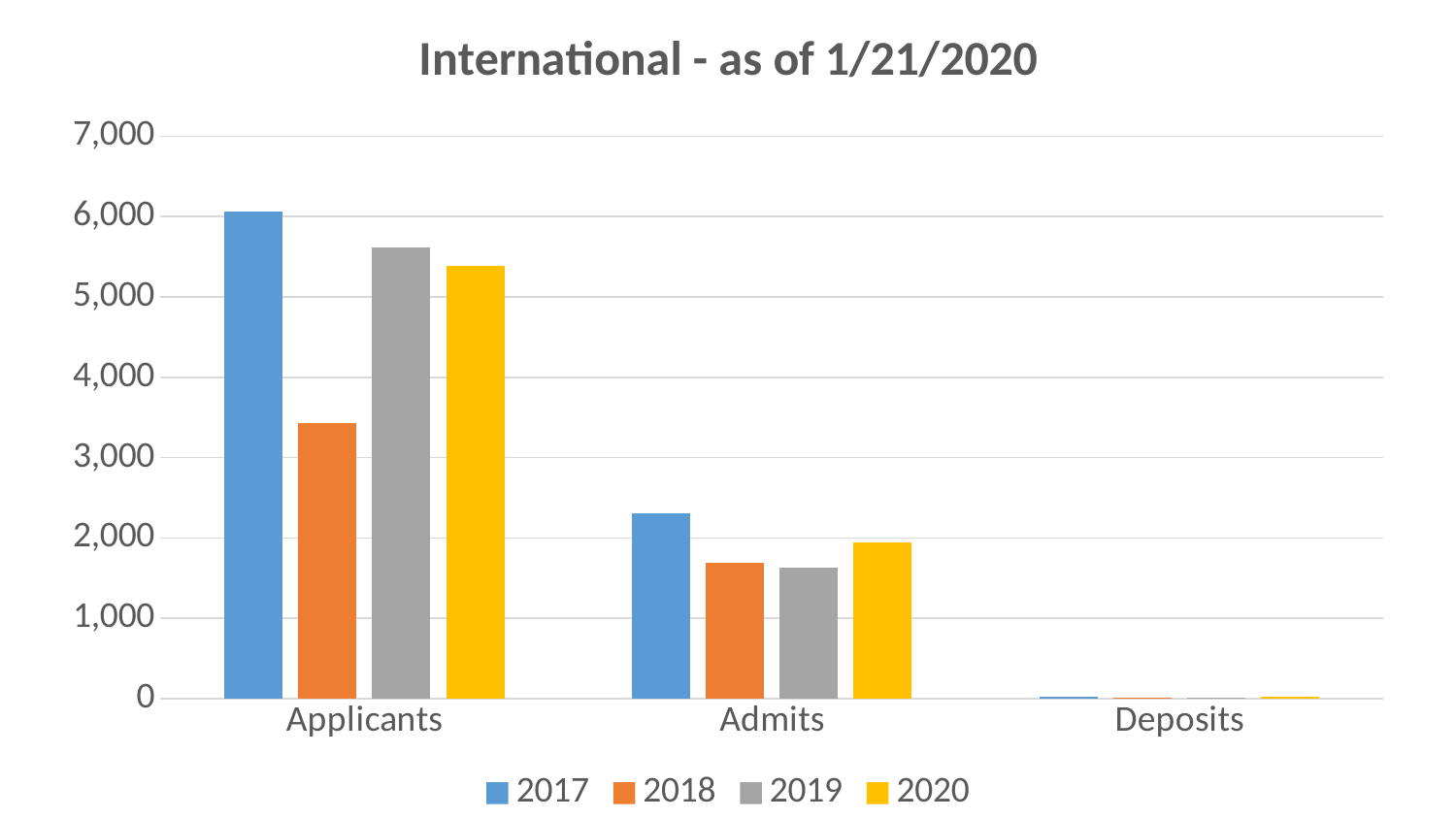
How many categories are shown on the x axis? 3 Which year has the highest value for Admits? 2017 What kind of chart is shown on the slide? bar chart Is the value for 2020 Admits greater or less than 2,000? less Is the value for 2017 Applicants greater or less than 5,000? greater Which year has the highest value for Applicants? 2017 For Admits, which is larger: the 2018 value or the 2020 value? 2020 Which year has the lowest value for Applicants? 2018 For Applicants, which is larger: the 2019 value or the 2020 value? 2019 What is the title of the chart? International - as of 1/21/2020 Is the value for 2018 Applicants greater or less than 4,000? less How many series does the legend list? 4